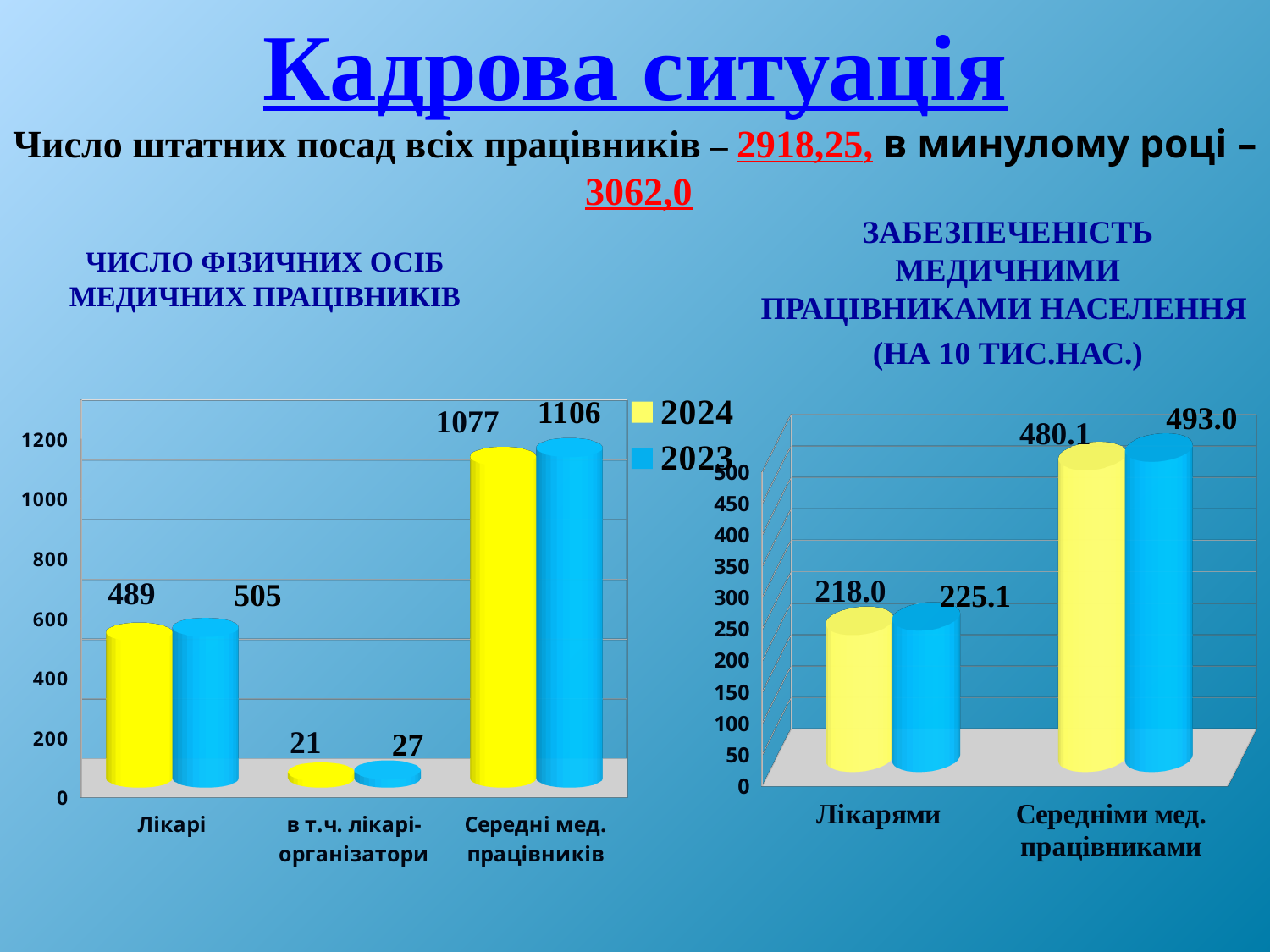
In the left chart (ЧИСЛО ФІЗИЧНИХ ОСІБ МЕДИЧНИХ ПРАЦІВНИКІВ), which category has the highest values? Середні мед. працівників In the left chart (ЧИСЛО ФІЗИЧНИХ ОСІБ МЕДИЧНИХ ПРАЦІВНИКІВ), how many series does the legend list? 2 In the left chart (ЧИСЛО ФІЗИЧНИХ ОСІБ МЕДИЧНИХ ПРАЦІВНИКІВ), what is the 2023 value for Середні мед. працівників? 1106 In the right chart (ЗАБЕЗПЕЧЕНІСТЬ МЕДИЧНИМИ ПРАЦІВНИКАМИ НАСЕЛЕННЯ), what is the difference between the 2023 and 2024 values for Лікарями? 7.1 In the left chart (ЧИСЛО ФІЗИЧНИХ ОСІБ МЕДИЧНИХ ПРАЦІВНИКІВ), what is the 2024 value for в т.ч. лікарі-організатори? 21 In the right chart (ЗАБЕЗПЕЧЕНІСТЬ МЕДИЧНИМИ ПРАЦІВНИКАМИ НАСЕЛЕННЯ), what is the 2023 value for Середніми мед. працівниками? 493.0 In the right chart (ЗАБЕЗПЕЧЕНІСТЬ МЕДИЧНИМИ ПРАЦІВНИКАМИ НАСЕЛЕННЯ), which is larger for Середніми мед. працівниками: the 2024 value or the 2023 value? 2023 In the right chart (ЗАБЕЗПЕЧЕНІСТЬ МЕДИЧНИМИ ПРАЦІВНИКАМИ НАСЕЛЕННЯ), what is the 2024 value for Лікарями? 218.0 What type of chart is the right chart (ЗАБЕЗПЕЧЕНІСТЬ МЕДИЧНИМИ ПРАЦІВНИКАМИ НАСЕЛЕННЯ)? Bar chart In the left chart (ЧИСЛО ФІЗИЧНИХ ОСІБ МЕДИЧНИХ ПРАЦІВНИКІВ), what is the difference between the 2023 and 2024 values for Лікарі? 16 In the left chart (ЧИСЛО ФІЗИЧНИХ ОСІБ МЕДИЧНИХ ПРАЦІВНИКІВ), how many categories are shown on the x axis? 3 In the left chart (ЧИСЛО ФІЗИЧНИХ ОСІБ МЕДИЧНИХ ПРАЦІВНИКІВ), what is the 2024 value for Лікарі? 489